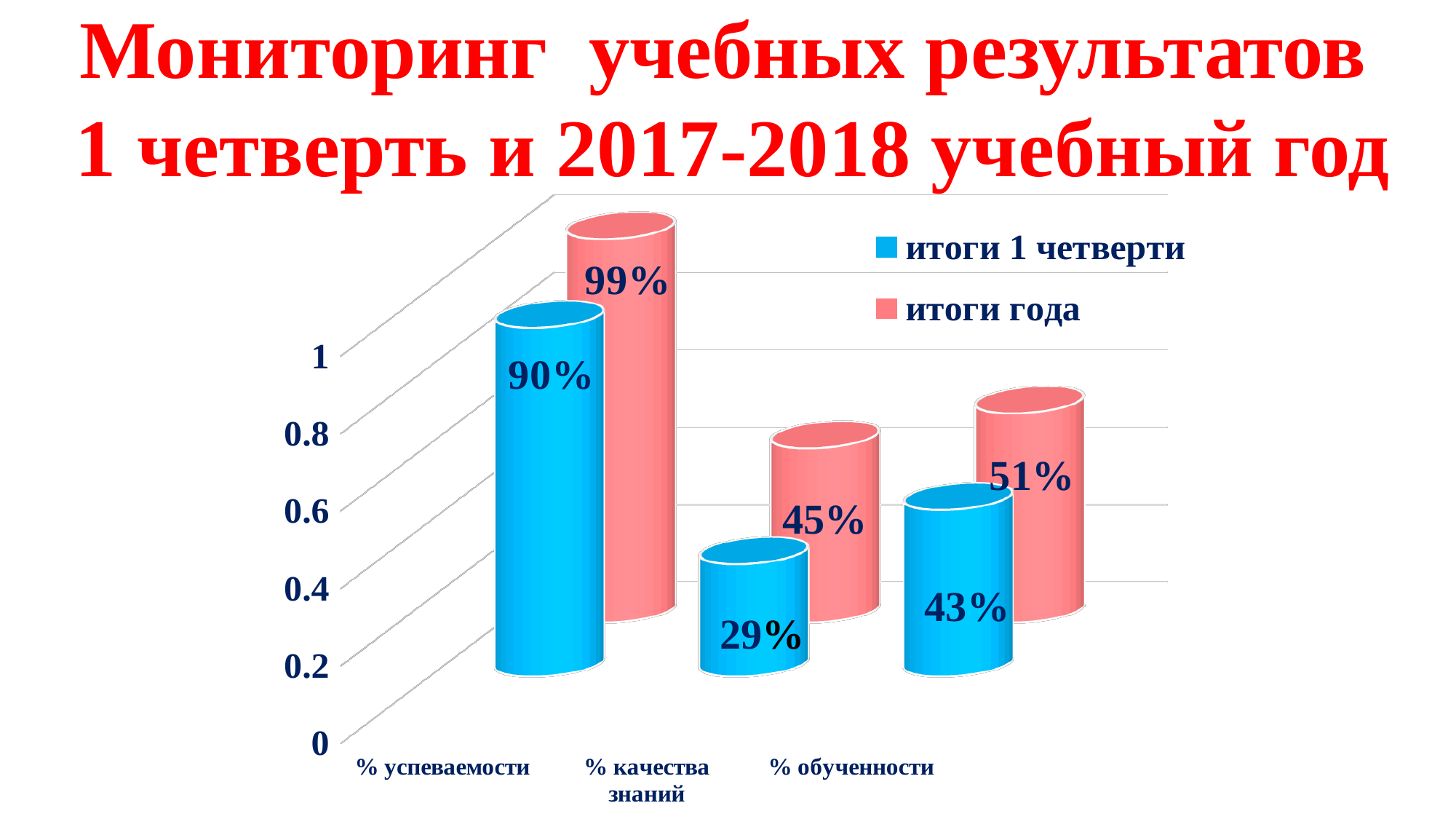
How many categories are shown on the x axis? 3 Which category has the lowest value in the итоги 1 четверти series? % качества знаний Which category has the highest value in the итоги года series? % успеваемости What is the value for % успеваемости in the итоги 1 четверти series? 90% How many series does the legend list? 2 What is the difference between the итоги года and итоги 1 четверти values for % качества знаний? 16% Which is larger for % обученности: итоги 1 четверти or итоги года? итоги года What kind of chart is shown on the slide? bar chart What is the value for % успеваемости in the итоги года series? 99% What is the value for % качества знаний in the итоги 1 четверти series? 29% What is the value for % обученности in the итоги года series? 51% Which colour represents the итоги года series? pink